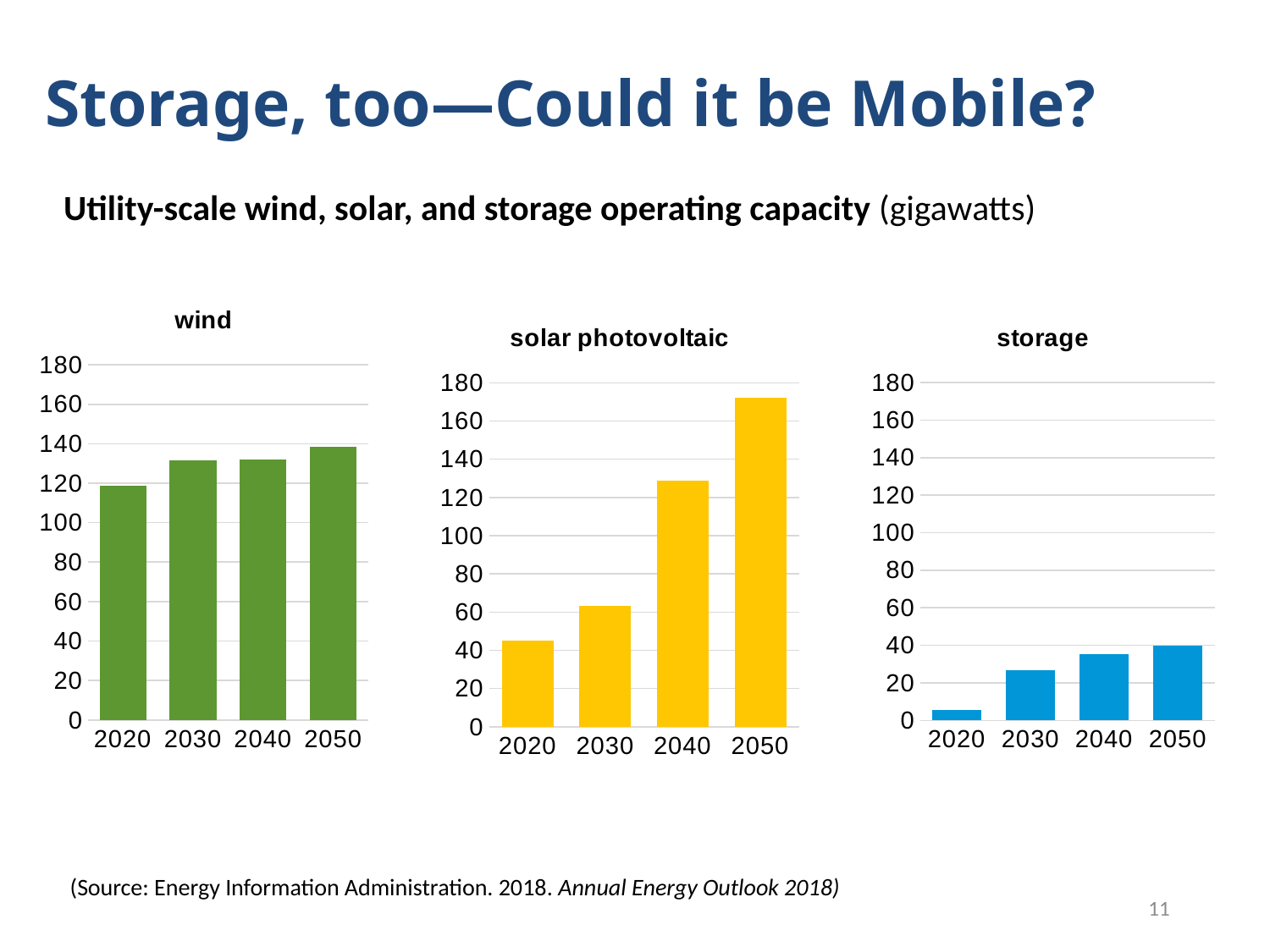
In the solar photovoltaic chart, is the value for 2050 greater or less than 160? greater Do the values in the solar photovoltaic chart rise or fall from 2020 to 2050? rise In the solar photovoltaic chart, which is larger, the value for 2040 or the value for 2030? 2040 In the storage chart, which year has the lowest value? 2020 In the wind chart, which year has the highest operating capacity? 2050 How many years are shown on the x axis of the storage chart? 4 In the storage chart, is the value for 2050 greater or less than 60? less In the solar photovoltaic chart, is the value for 2030 greater or less than 80? less In the solar photovoltaic chart, which year has the highest value? 2050 In the wind chart, which year has the lowest operating capacity? 2020